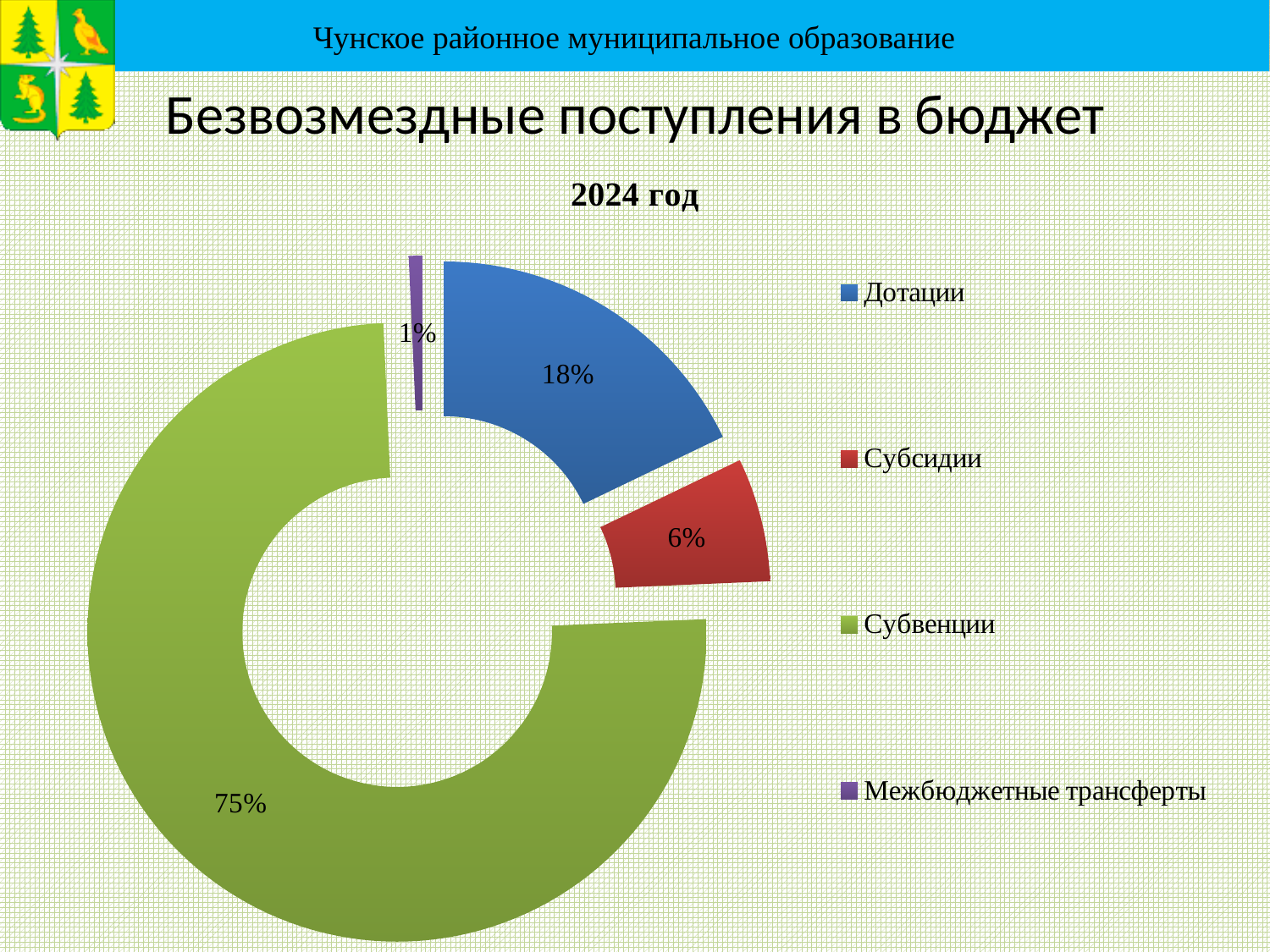
What is the difference in percentage points between Субвенции and Дотации? 57 What is the value shown for Межбюджетные трансферты? 1% How many categories does the chart show? 4 Which category has the largest share? Субвенции What is the value shown for Дотации? 18% What is the difference in percentage points between Дотации and Субсидии? 12 What is the title of the chart? 2024 год Which category has the smallest share? Межбюджетные трансферты What is the value shown for Субсидии? 6% Which is larger, Дотации or Субсидии? Дотации What kind of chart is shown on the slide? Doughnut (pie) chart What share of the chart does Субвенции account for? 75%